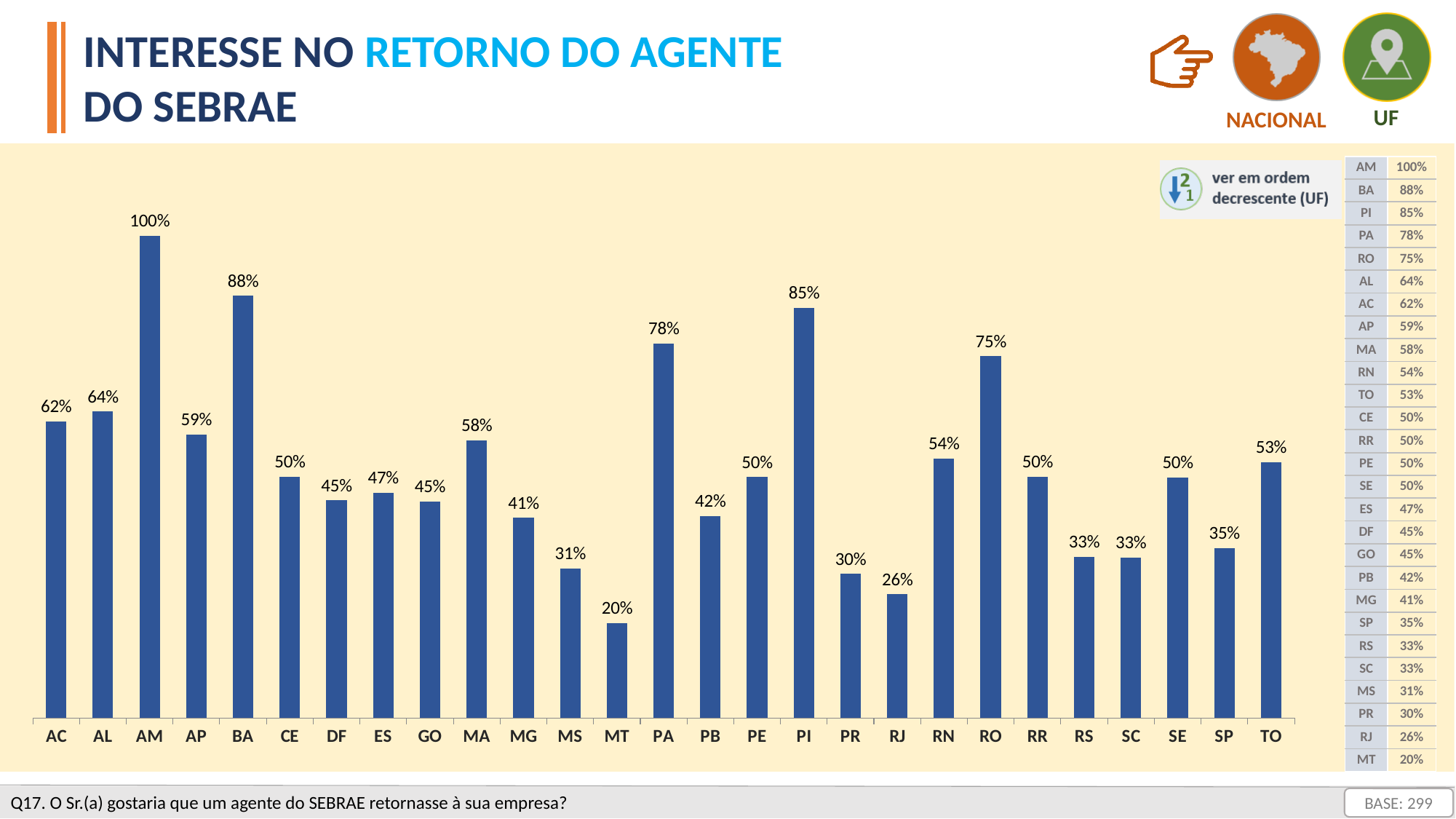
What is the base (sample size) shown on the slide? 299 What is the value for AM? 100% Which state has the lowest value? MT Which is larger, the value for RO or the value for RN? RO What is the difference between the values for BA and PA? 10% How many states are shown on the x axis? 27 Which state has the highest value? AM What is the value for MT? 20% What is the value for PI? 85% What is the difference between the values for AM and MT? 80% What kind of chart is shown? Bar chart What is the value for RJ? 26%